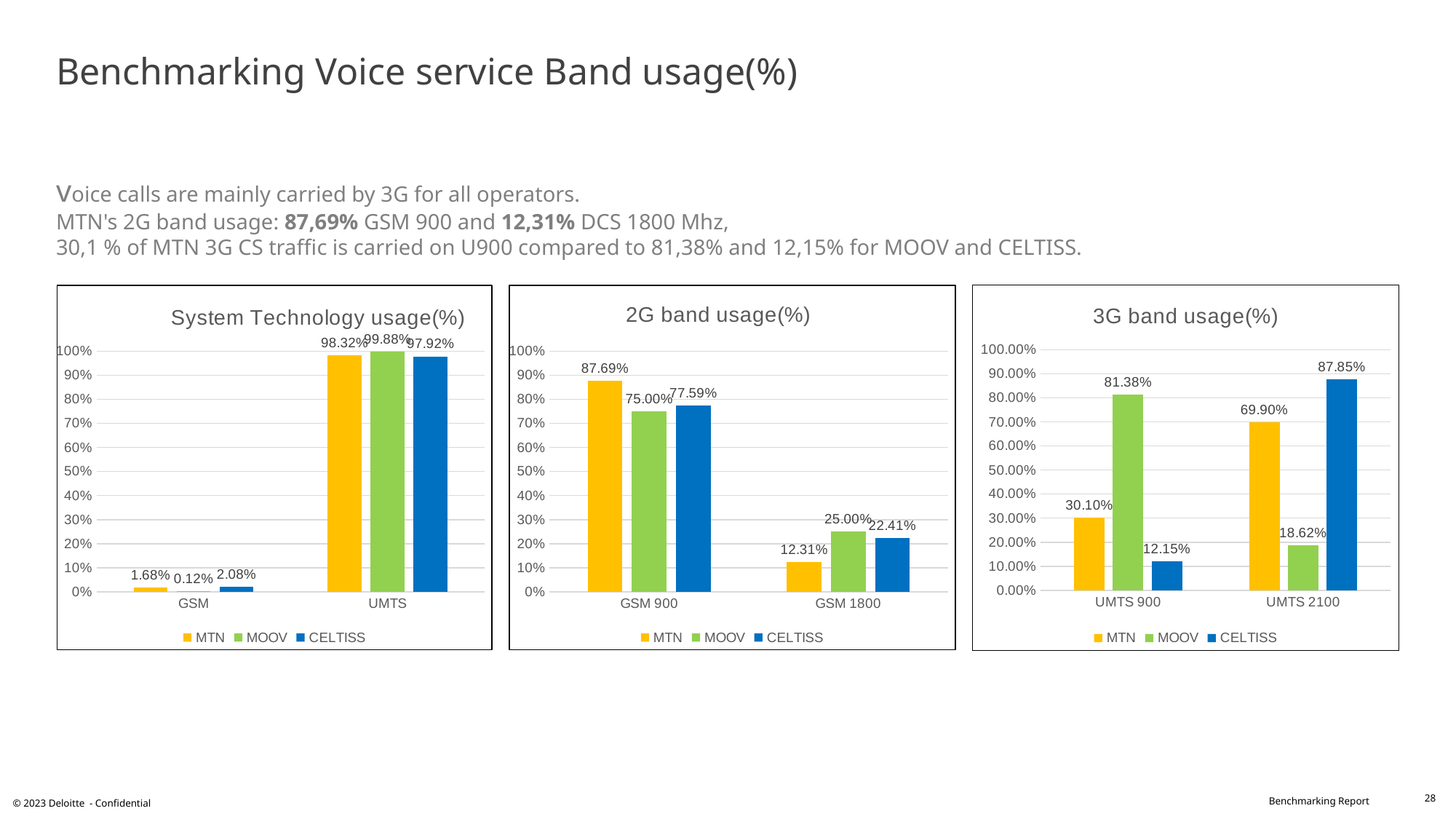
In the 'System Technology usage(%)' chart, which operator has the lowest value at GSM? MOOV In the '2G band usage(%)' chart, which is larger at GSM 1800: MOOV or CELTISS? MOOV In the '2G band usage(%)' chart, what is the value for MTN at GSM 900? 87.69% What kind of chart is the '3G band usage(%)' chart? Bar chart In the '3G band usage(%)' chart, what is the difference between CELTISS's value at UMTS 2100 and MTN's value at UMTS 2100? 17.95% In the '2G band usage(%)' chart, what is the difference between MOOV's value at GSM 900 and MOOV's value at GSM 1800? 50.00% In the '3G band usage(%)' chart, is the value for MTN at UMTS 900 greater or less than 40.00%? less In the 'System Technology usage(%)' chart, what is the value for CELTISS at GSM? 2.08% In the '3G band usage(%)' chart, which operator has the highest value at UMTS 2100? CELTISS How many series does the legend of the '2G band usage(%)' chart list? 3 In the '3G band usage(%)' chart, what is the value for MOOV at UMTS 900? 81.38% How many categories are shown on the x axis of the 'System Technology usage(%)' chart? 2